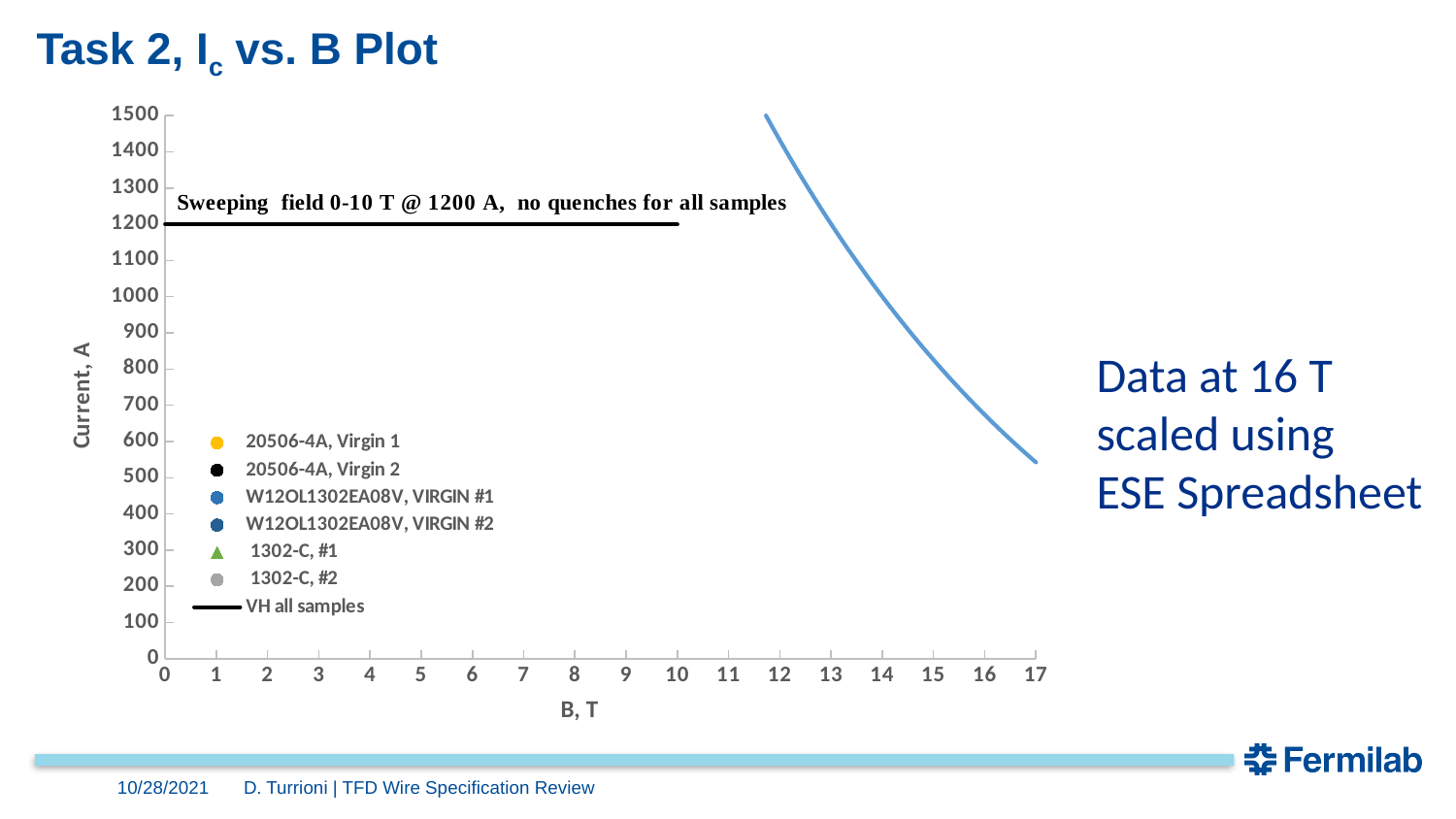
What is the highest tick value shown on the x axis of the chart? 17 What is the label of the y axis on the chart? Current, A Is the value of the blue curve at 17 T greater or less than the 1200 A level of the black line? less What current does the black 'VH all samples' line sit at on the chart? 1200 A What is the highest tick value shown on the y axis of the chart? 1500 What is the label of the x axis on the chart? B, T Over what field range does the black 'VH all samples' line extend, according to the annotation on the chart? 0-10 T How many entries does the chart's legend list? 7 According to the annotation on the chart, how many samples quenched during the 0-10 T field sweep at 1200 A? none Does the blue curve on the chart rise or fall as B increases from 12 T to 17 T? fall Is the value of the blue curve at 12 T greater or less than 1300? greater Is the value of the blue curve at 17 T greater or less than 600? less